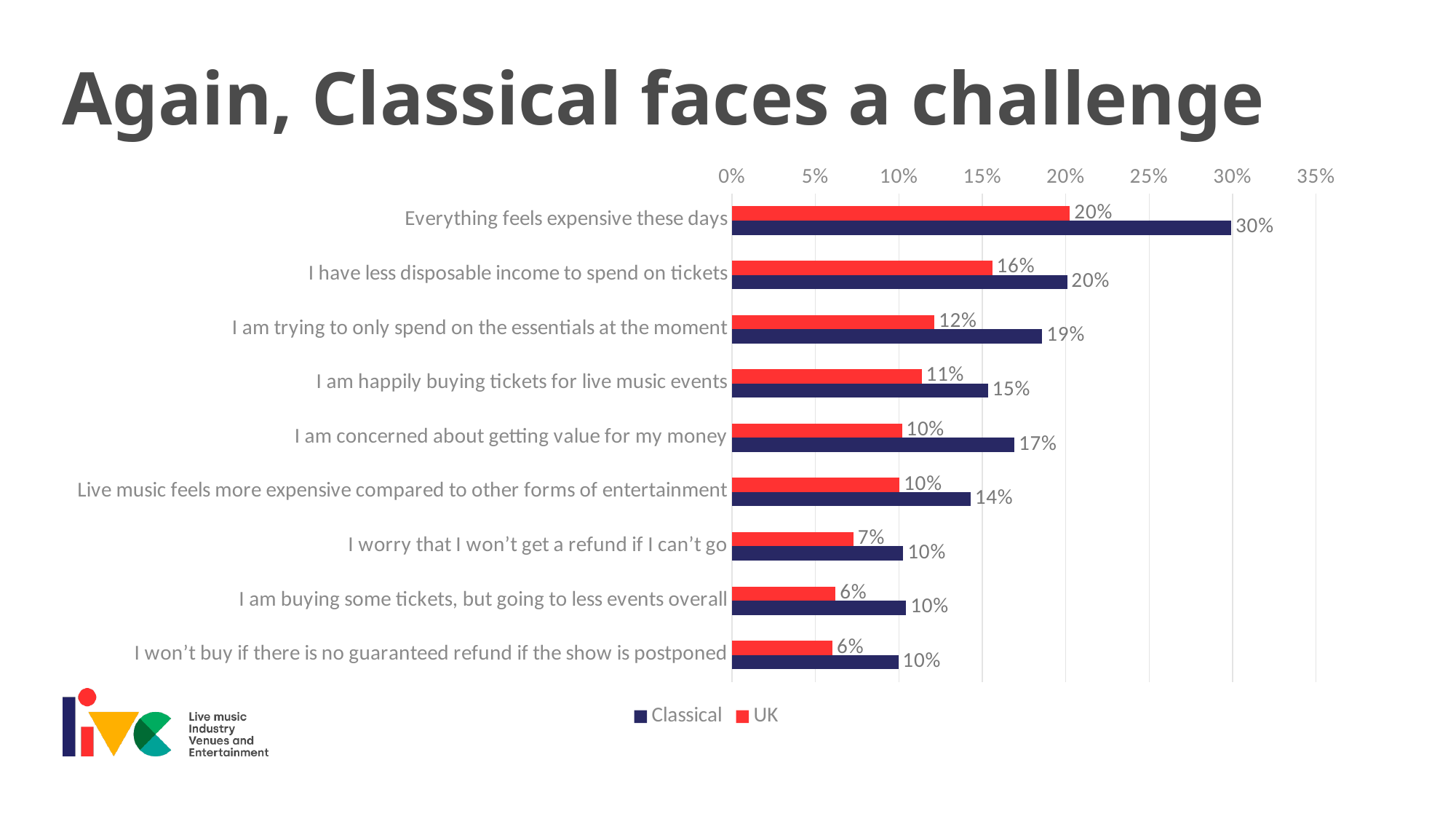
Which is larger for "I am happily buying tickets for live music events": the Classical value or the UK value? Classical What is the UK value for "I have less disposable income to spend on tickets"? 16% What is the difference between the Classical and UK values for "I am trying to only spend on the essentials at the moment"? 7% Which category has the lowest UK value? I am buying some tickets, but going to less events overall; I won't buy if there is no guaranteed refund if the show is postponed (both 6%) What is the Classical value for "Everything feels expensive these days"? 30% How many categories are shown on the chart? 9 What kind of chart is shown on the slide? Bar chart How many series does the legend list? 2 Which series is shown in red? UK Which category has the highest Classical value? Everything feels expensive these days What is the Classical value for "I am concerned about getting value for my money"? 17% What is the difference between the Classical and UK values for "Everything feels expensive these days"? 10%